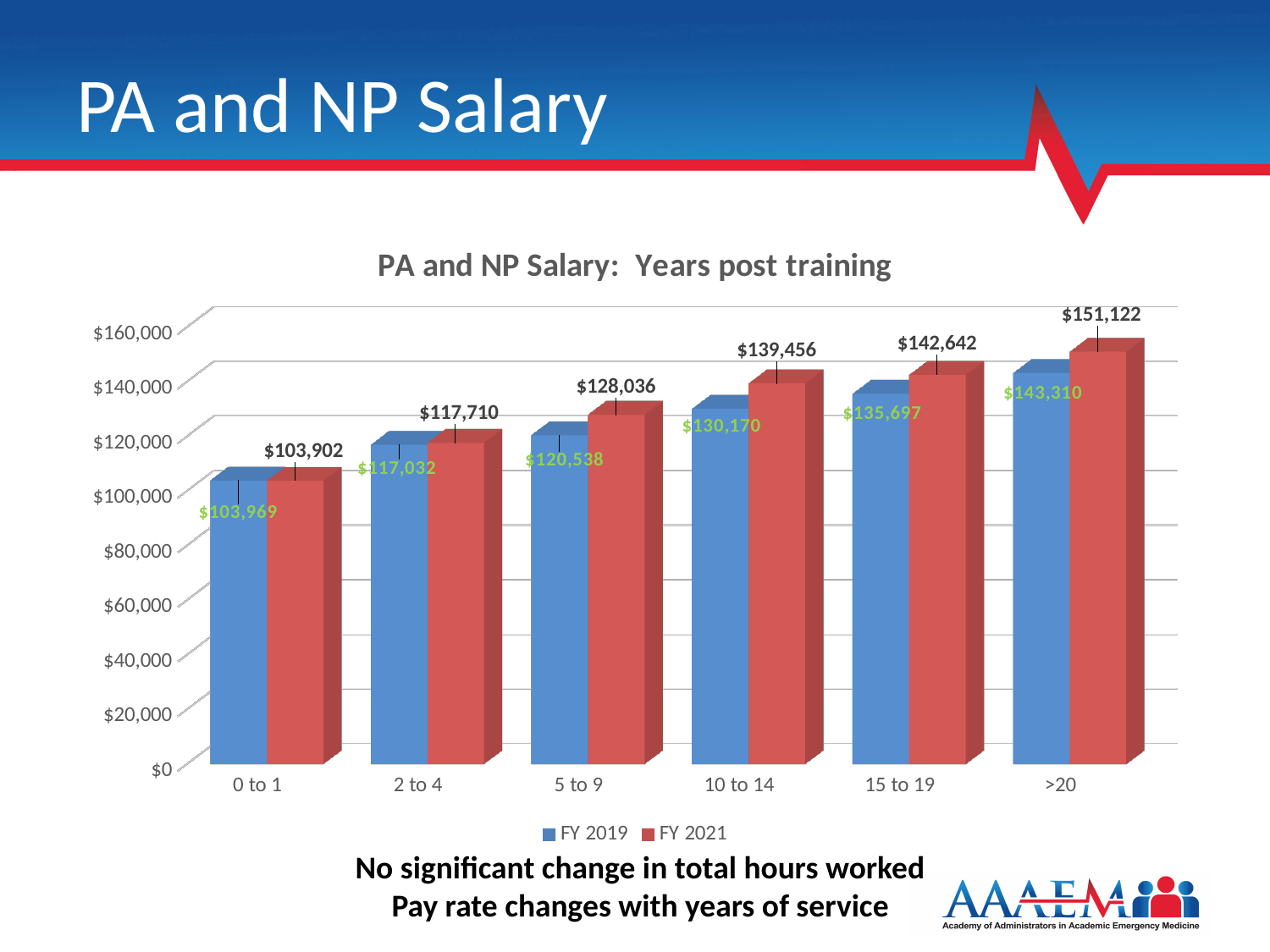
What is the FY 2021 salary for the >20 years post training category? $151,122 What is the FY 2019 salary for the 0 to 1 years post training category? $103,969 What is the difference between the FY 2021 and FY 2019 salaries for the 10 to 14 category? $9,286 Which years-post-training category has the lowest FY 2019 salary? 0 to 1 What is the difference between the FY 2021 and FY 2019 salaries for the >20 category? $7,812 What is the FY 2021 salary for the 5 to 9 years post training category? $128,036 Do the FY 2021 salaries rise or fall as years post training increase along the x axis? rise Which is larger for the 15 to 19 category: the FY 2019 salary or the FY 2021 salary? FY 2021 What is the FY 2019 salary for the 10 to 14 years post training category? $130,170 How many series does the legend list? 2 Which years-post-training category has the highest FY 2021 salary? >20 How many years-post-training categories are shown on the x axis? 6